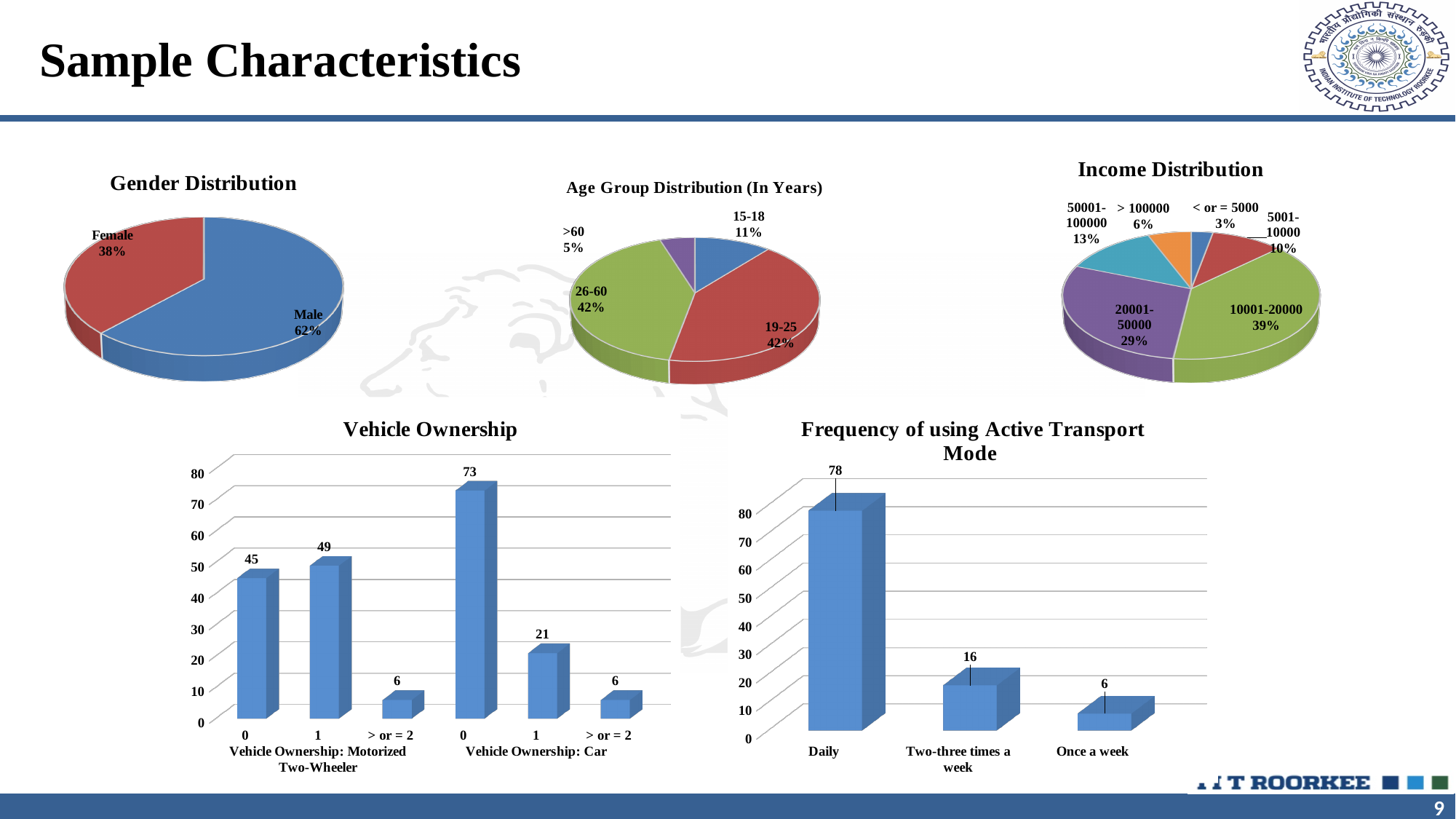
In the Income Distribution chart, what is the difference between the shares of the 20001-50000 group and the > 100000 group? 23% In the Age Group Distribution (In Years) chart, how many age groups are shown? 4 In the Age Group Distribution (In Years) chart, which age group has the smallest share? >60 In the Gender Distribution chart, what share of the sample is Male? 62% In the Frequency of using Active Transport Mode chart, what is the value for Two-three times a week? 16 In the Gender Distribution chart, what kind of chart is shown? pie chart In the Age Group Distribution (In Years) chart, what share is the 15-18 age group? 11% In the Vehicle Ownership chart, what is the difference between the values for 1 and 0 under Vehicle Ownership: Motorized Two-Wheeler? 4 In the Frequency of using Active Transport Mode chart, do the values rise or fall from Daily to Once a week? fall In the Vehicle Ownership chart, what is the value for 0 under Vehicle Ownership: Car? 73 In the Income Distribution chart, what share is the 50001-100000 group? 13% In the Income Distribution chart, which income group has the largest share? 10001-20000